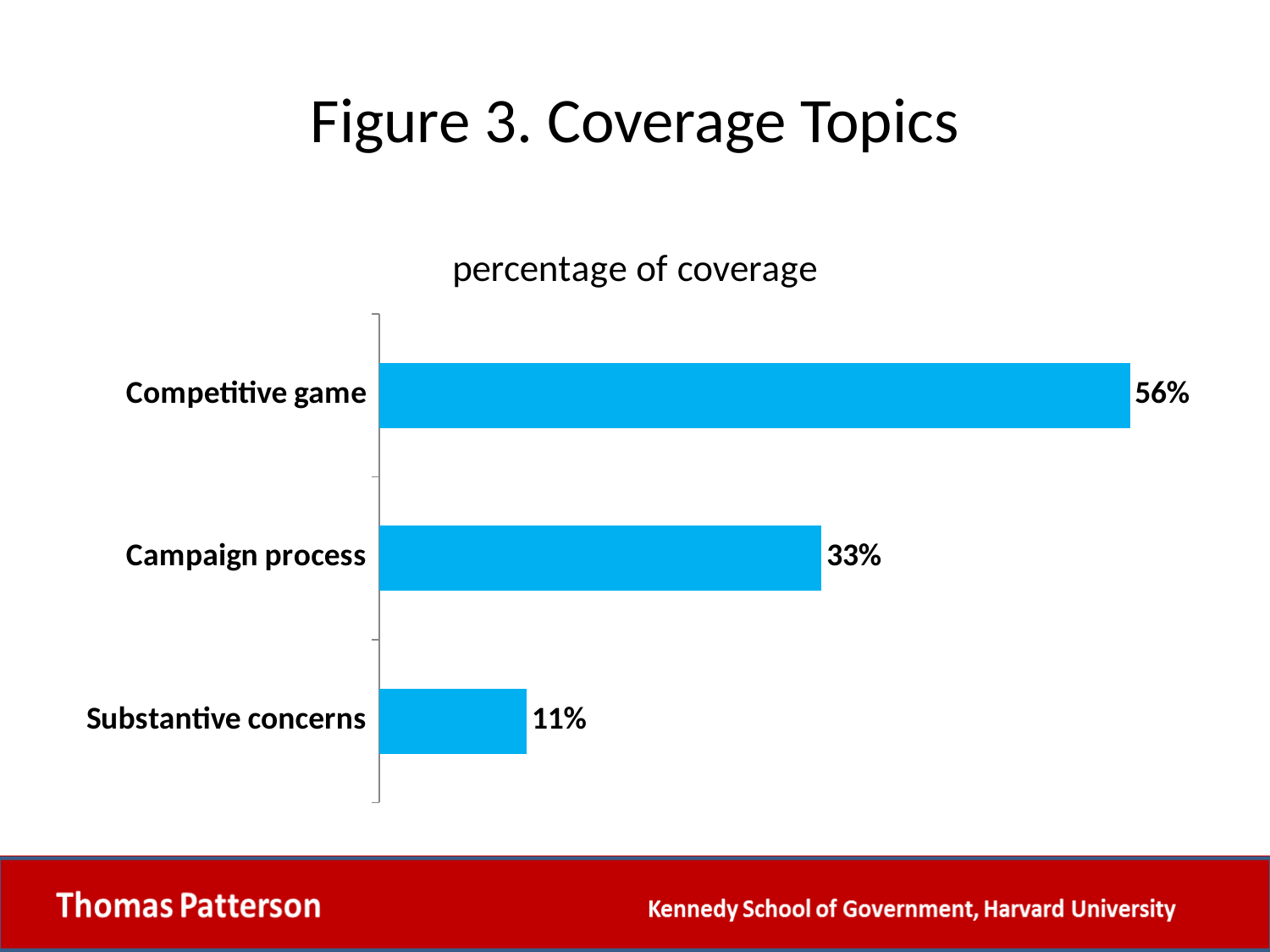
What is the title of the chart? percentage of coverage What is the difference in percentage of coverage between Competitive game and Campaign process? 23% How many topics are shown in the chart? 3 Which topic has the highest percentage of coverage? Competitive game What is the percentage of coverage for Substantive concerns? 11% What is the difference in percentage of coverage between Campaign process and Substantive concerns? 22% What colour are the bars in the chart? Blue Which topic has the lowest percentage of coverage? Substantive concerns What kind of chart is shown on the slide? Bar chart What is the percentage of coverage for Campaign process? 33% What is the percentage of coverage for Competitive game? 56% Which has a larger percentage of coverage, Campaign process or Substantive concerns? Campaign process